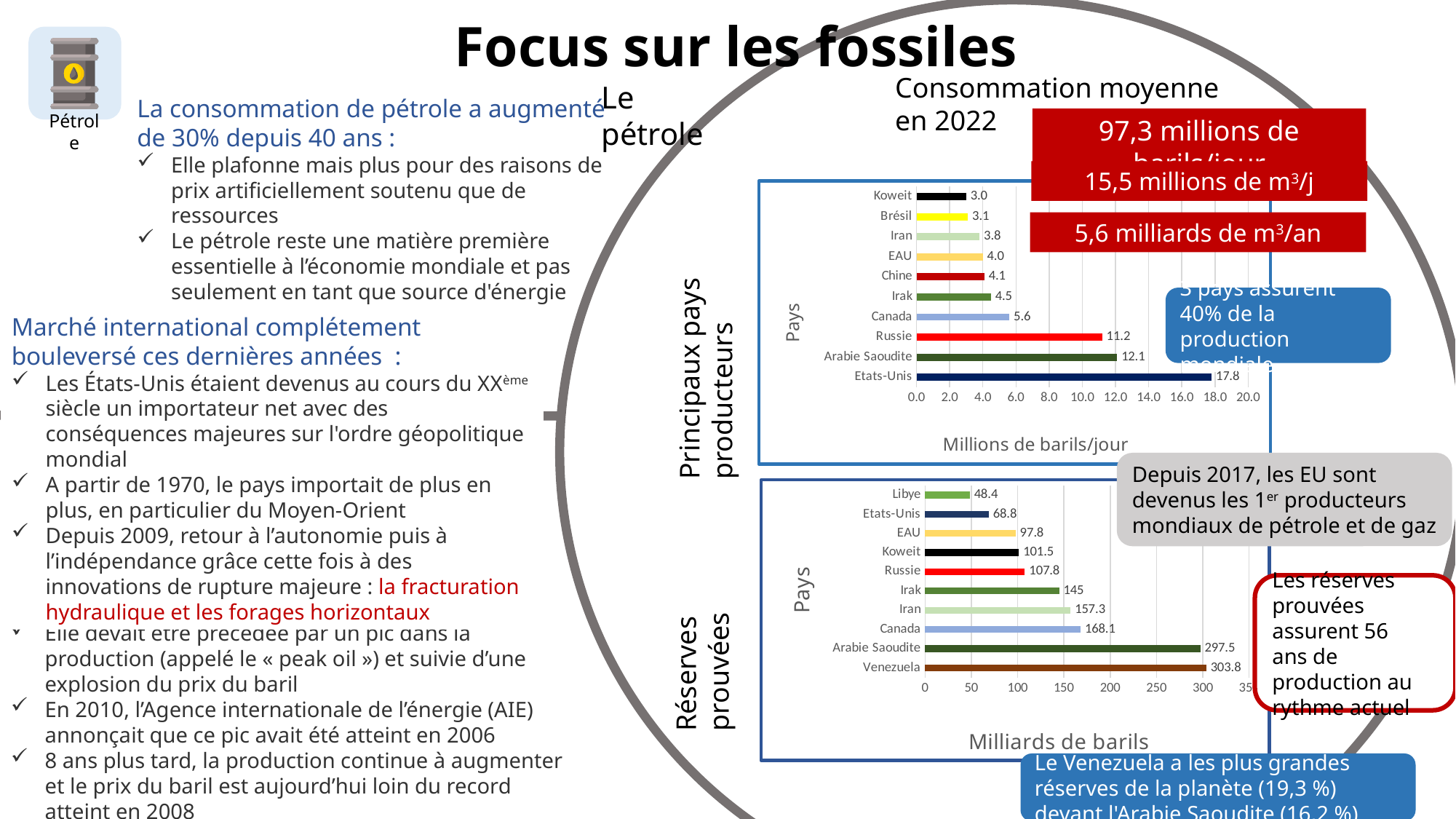
In the bottom chart (Réserves prouvées), which country has the lowest value? Libye In the top chart (Principaux pays producteurs), what is the value for Etats-Unis? 17.8 In the bottom chart (Réserves prouvées), what is the difference between Venezuela and Arabie Saoudite? 6.3 In the bottom chart (Réserves prouvées), what is the value for Venezuela? 303.8 In the top chart (Principaux pays producteurs), what is the x-axis label? Millions de barils/jour In the top chart (Principaux pays producteurs), which country has the lowest value? Koweit In the top chart (Principaux pays producteurs), how many countries are shown? 10 In the bottom chart (Réserves prouvées), what is the value for Canada? 168.1 What type of chart is the bottom chart (Réserves prouvées)? Bar chart In the top chart (Principaux pays producteurs), what is the difference between Etats-Unis and Arabie Saoudite? 5.7 In the bottom chart (Réserves prouvées), which is larger, Irak or Iran? Iran In the top chart (Principaux pays producteurs), what is the value for Russie? 11.2